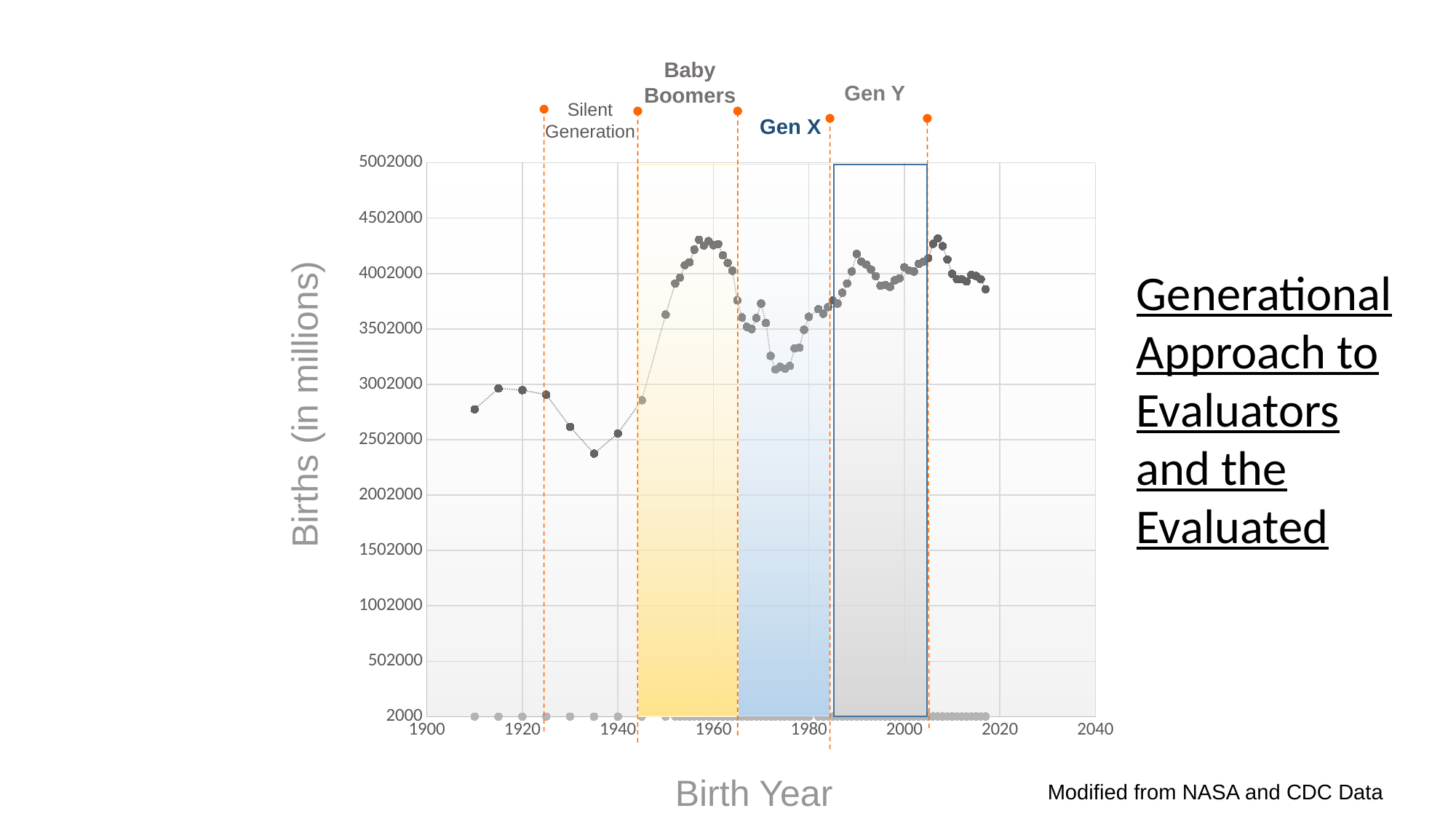
What kind of chart is shown on the slide? Scatter (line) chart Which birth year has the lowest number of births on the chart? 1935 Do births rise or fall between birth years 1945 and 1957? rise Is the value for birth year 1910 greater or less than 3002000? less Do births rise or fall between birth years 1960 and 1975? fall Is the value for birth year 1935 greater or less than 2502000? less Is the value for birth year 1975 greater or less than 3502000? less What is the title of the x axis of the chart? Birth Year What is the title of the y axis of the chart? Births (in millions) Which has more births, birth year 1935 or birth year 1960? 1960